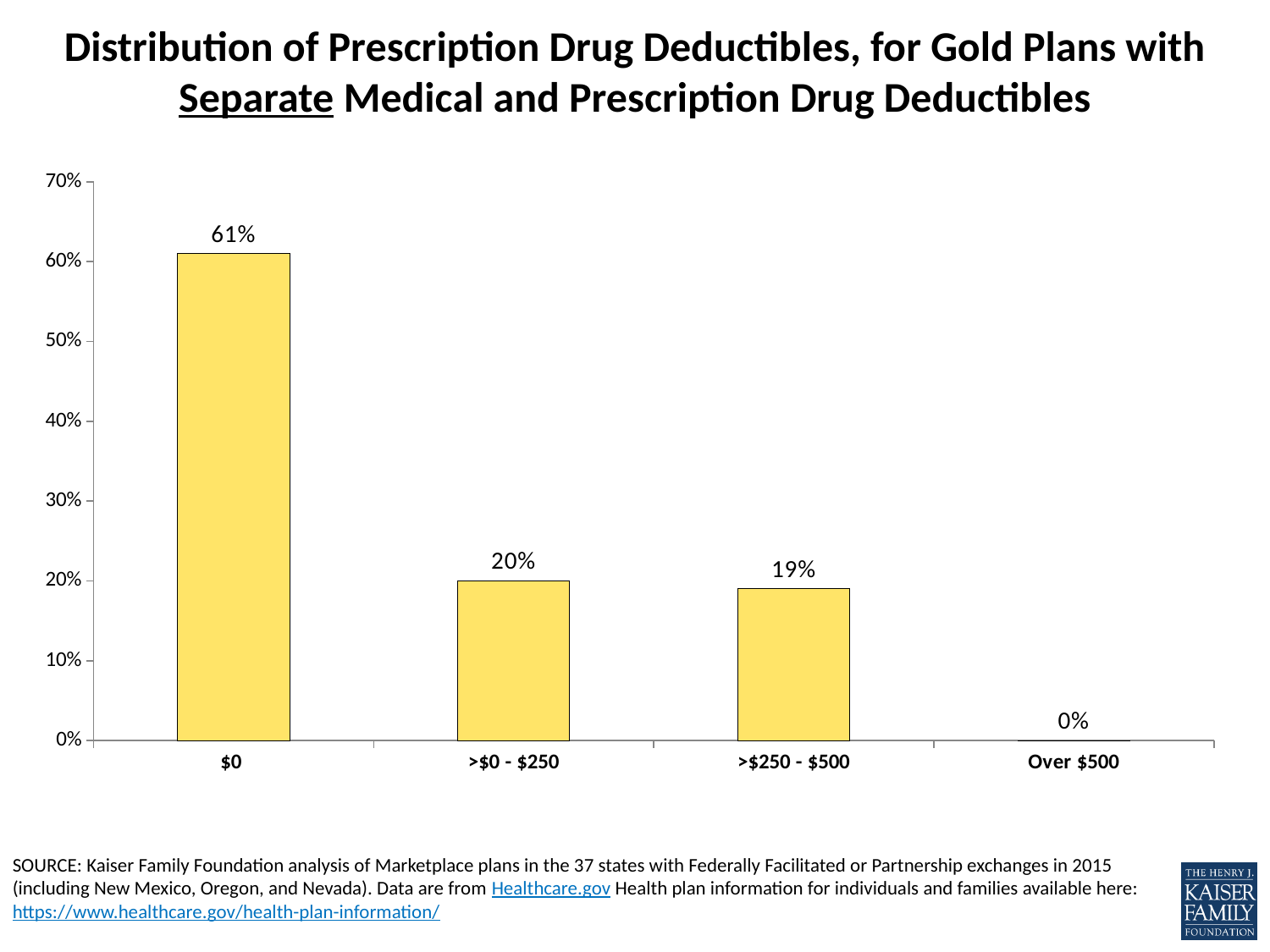
What is the value for the Over $500 category? 0% Which deductible category has the highest share of plans? $0 What kind of chart is shown on the slide? Bar chart What is the value for the >$250 - $500 category? 19% Which is larger, the value for $0 or the value for >$250 - $500? $0 What is the difference between the >$0 - $250 category and the >$250 - $500 category? 1 percentage point Which deductible category has the lowest share of plans? Over $500 What is the difference between the $0 category and the >$0 - $250 category? 41 percentage points How many deductible categories are shown on the x axis? 4 What is the value for the >$0 - $250 category? 20% Is the value for the $0 category greater or less than 50%? greater What percentage of Gold plans with separate deductibles have a $0 prescription drug deductible? 61%